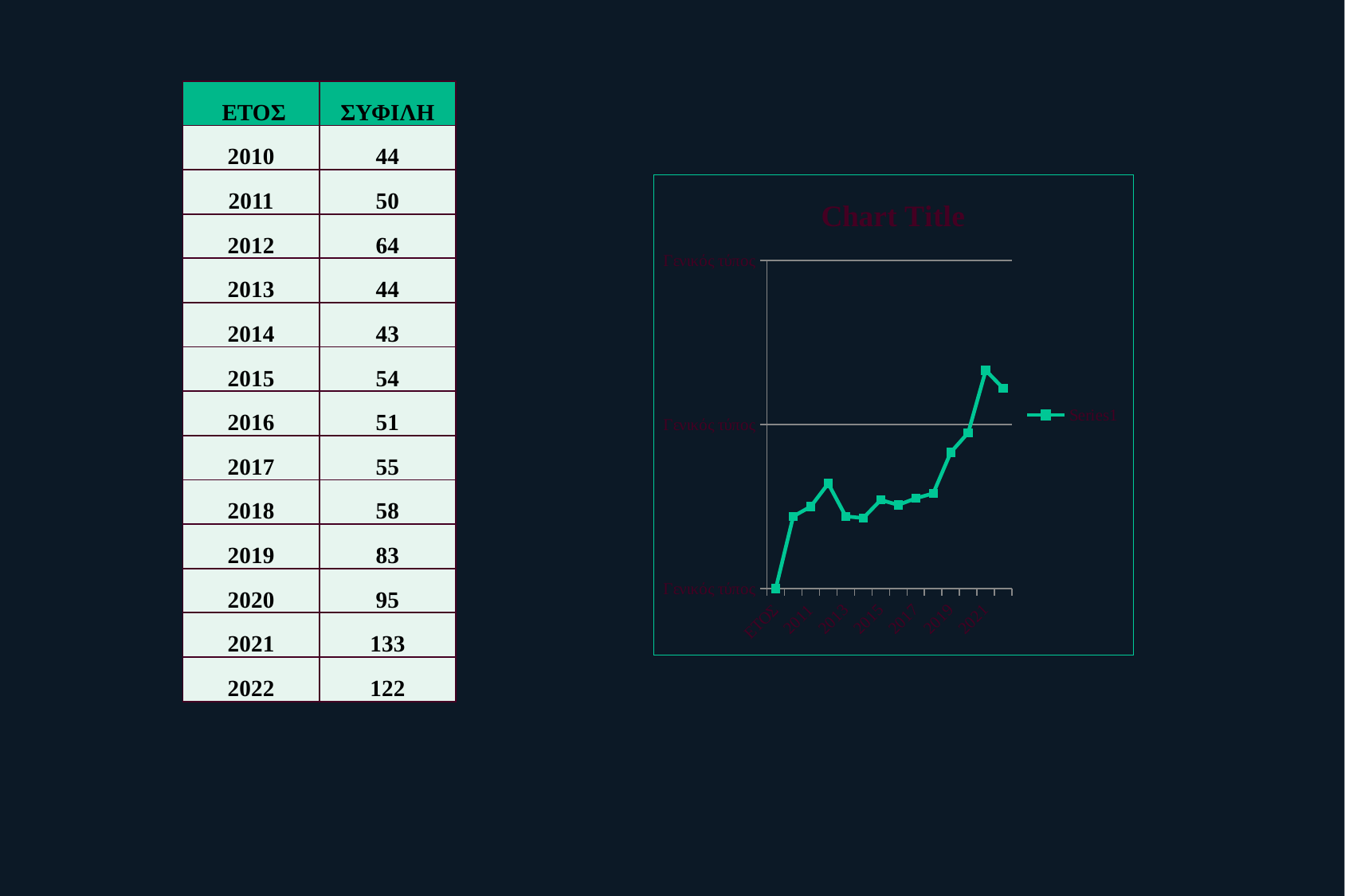
Do the plotted values generally rise or fall from the first point to the last point along the x axis? rise What is the value for 2021? 133 What is the title shown on the chart? Chart Title Which year has the lowest value in the plotted data? 2014 Is the last plotted point higher or lower than the first plotted point? higher Is the last plotted point higher or lower than the point immediately before it? lower How many data points are plotted on the line chart? 14 How many series does the chart legend list? 1 Which year has the highest value in the plotted data? 2021 What is the legend entry shown on the chart? Series1 What is the difference between the values for 2021 and 2022? 11 What kind of chart is shown on the slide? line chart